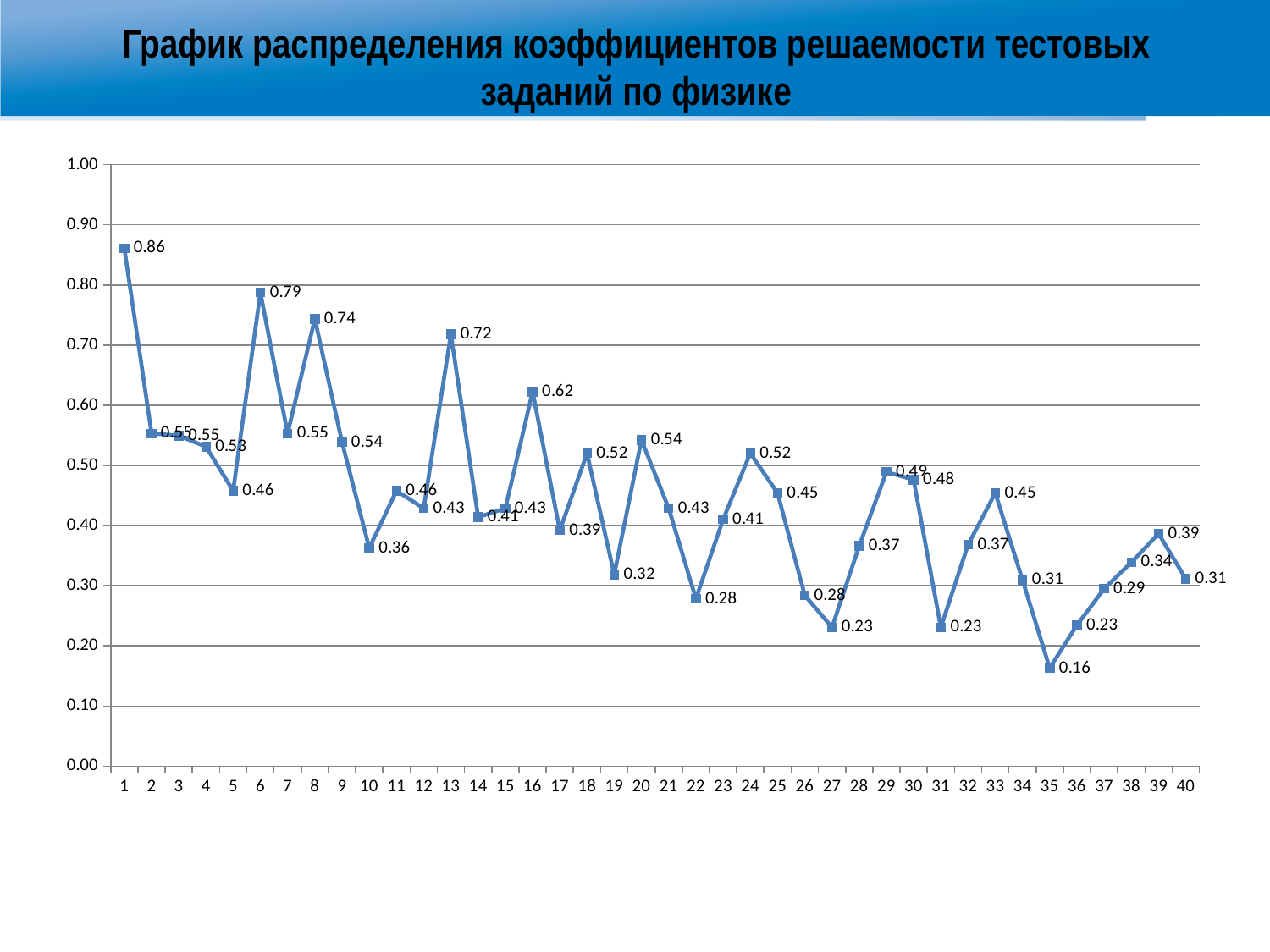
What is the value for task 13? 0.72 How many tasks are plotted on the x axis? 40 What is the title of the chart? График распределения коэффициентов решаемости тестовых заданий по физике What kind of chart is shown on the slide? line chart What is the value for task 1? 0.86 What is the value for task 40? 0.31 What is the value for task 35? 0.16 Which task has the highest value? 1 Which task has the lowest value? 35 What is the difference between the values for task 16 and task 17? 0.23 Which is larger, the value for task 8 or the value for task 13? task 8 What is the difference between the values for task 1 and task 6? 0.07